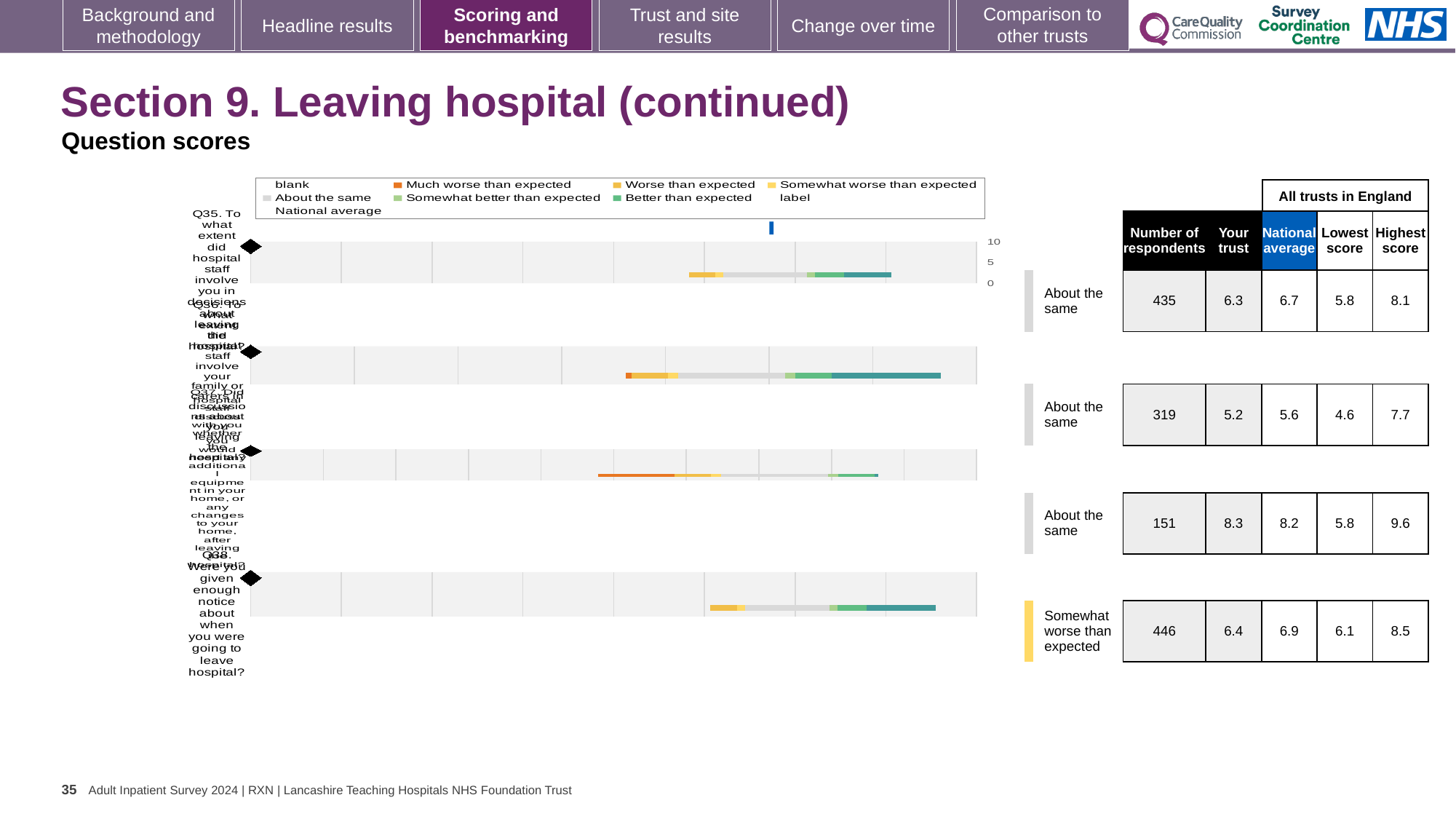
Which question row is rated 'Somewhat worse than expected'? Q38 (the last row) What is the highest score across all trusts in England for Q35 (the first row)? 8.1 What is the national average for Q35 (the first row)? 6.7 What is the difference between the national average and the 'Your trust' score for Q35 (the first row)? 0.4 What is the number of respondents for Q35 (the first row)? 435 What kind of chart is shown on the slide? bar chart How many question rows are plotted in the chart? 4 Is the 'Your trust' score for Q38 (the last row) larger or smaller than its national average? smaller Which row has the lowest 'Your trust' score in the table? the second row (5.2) What is the 'Your trust' score for Q35 (the first row)? 6.3 What is the lowest score across all trusts in England for Q38 (the last row)? 6.1 Which row has the highest 'Your trust' score in the table? the third row (8.3)